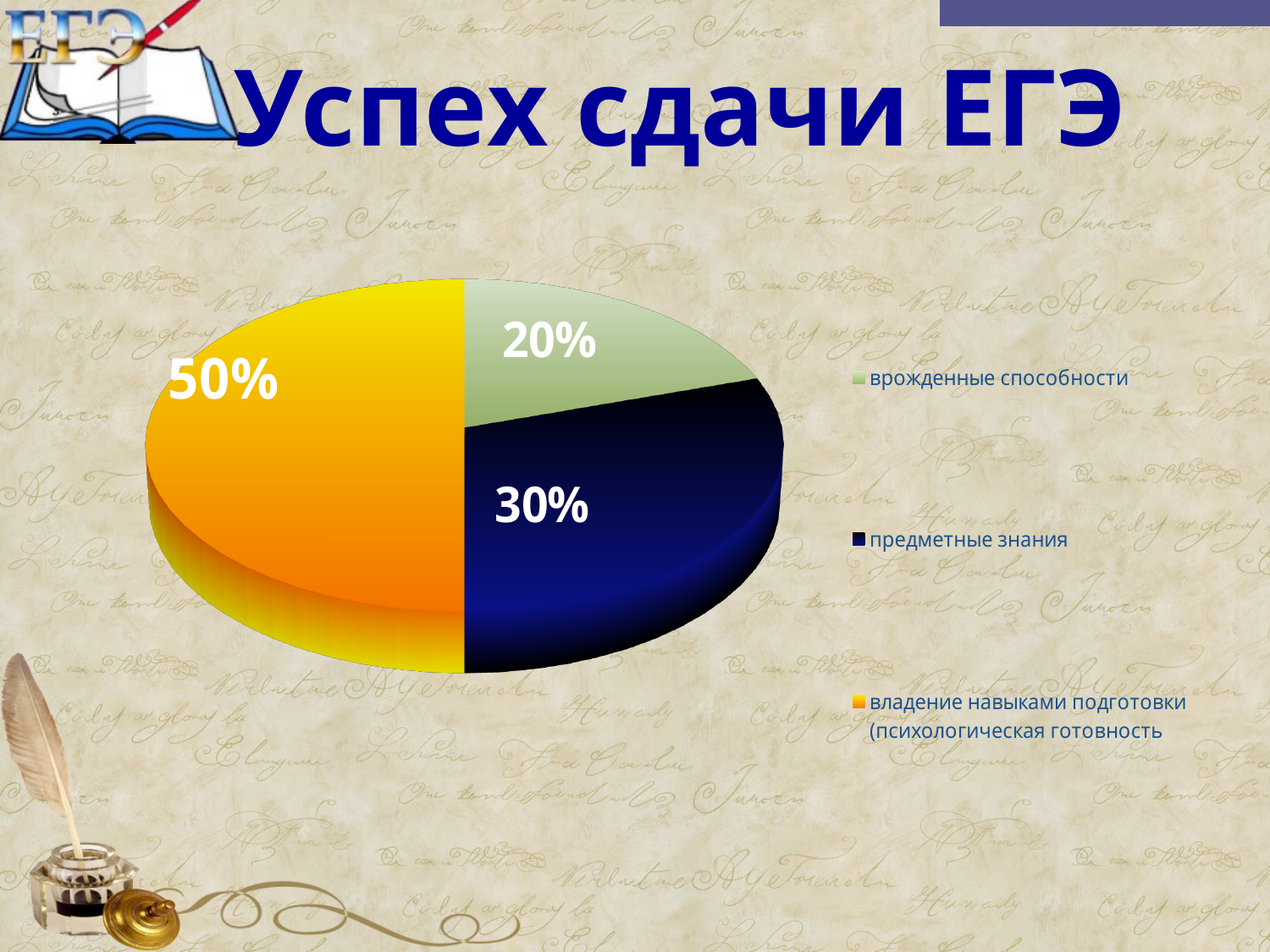
How many slices does the pie chart have? 3 How many entries does the legend list? 3 Which category has the smallest slice of the pie? врожденные способности What share of the pie is labelled "врожденные способности"? 20% What is the difference in percentage points between the slice for "предметные знания" and the slice for "врожденные способности"? 10% Which is larger: the slice for "предметные знания" or the slice for "врожденные способности"? предметные знания What kind of chart is shown on the slide? pie chart What share of the pie is labelled "владение навыками подготовки (психологическая готовность"? 50% What colour is the slice for "предметные знания"? dark blue What is the title of the slide containing the pie chart? Успех сдачи ЕГЭ What share of the pie is labelled "предметные знания"? 30% Which category has the largest slice of the pie? владение навыками подготовки (психологическая готовность